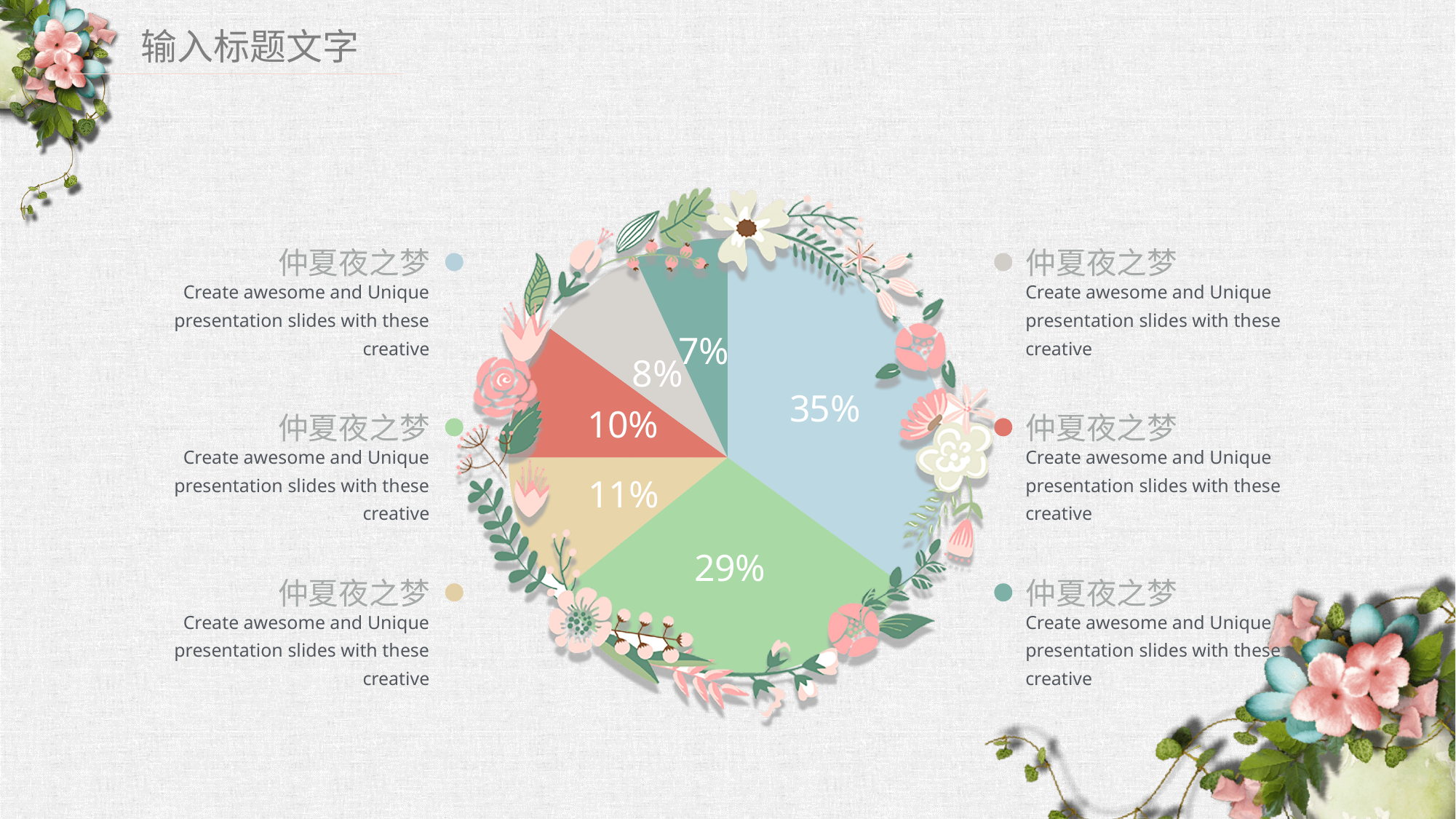
What kind of chart is shown on the slide? pie chart What percentage is shown on the grey slice of the pie chart? 8% What is the smallest percentage shown on the pie chart? 7% What percentage is shown on the red slice of the pie chart? 10% Which slice is larger, the tan slice at 11% or the red slice at 10%? the tan slice (11%) What percentage is shown on the light blue slice of the pie chart? 35% What is the largest percentage shown on the pie chart? 35% What colour is the slice labelled 7%? teal What percentage is shown on the green slice of the pie chart? 29% What is the difference between the light blue slice (35%) and the green slice (29%)? 6% What do the two largest slices (35% and 29%) add up to? 64% How many slices does the pie chart have? 6